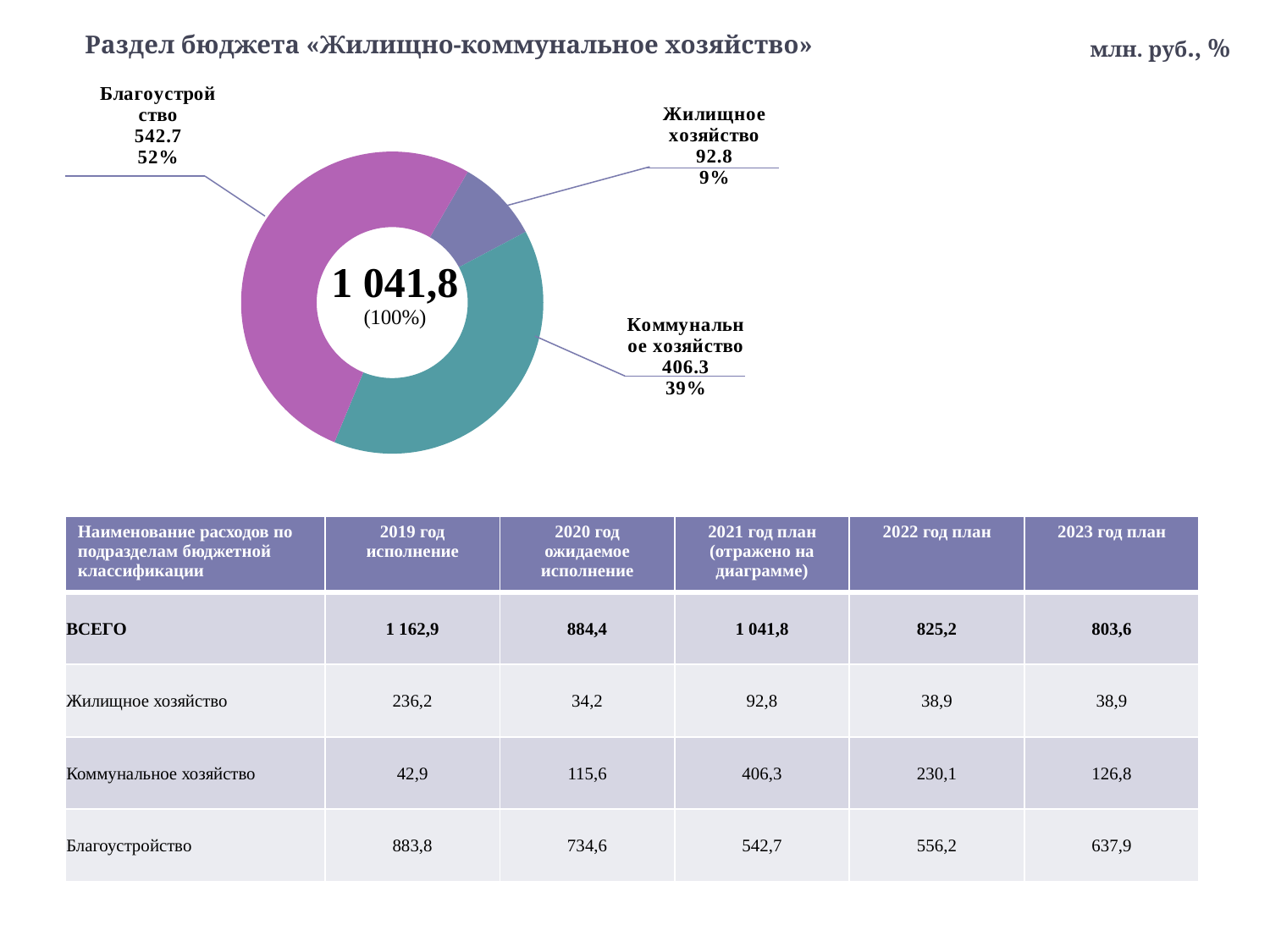
What value is shown for Благоустройство on the donut chart? 542.7 How many slices does the donut chart have? 3 What value is shown for Жилищное хозяйство on the donut chart? 92.8 What share of the donut chart does Коммунальное хозяйство represent? 39% What total value is shown in the centre of the donut chart? 1 041,8 Which is larger on the donut chart: Коммунальное хозяйство or Жилищное хозяйство? Коммунальное хозяйство What share of the donut chart does Благоустройство represent? 52% What is the difference between the values for Благоустройство and Коммунальное хозяйство on the donut chart? 136.4 What value is shown for Коммунальное хозяйство on the donut chart? 406.3 Which category has the largest slice in the donut chart? Благоустройство Which category has the smallest slice in the donut chart? Жилищное хозяйство What kind of chart is shown on the slide? Pie (donut) chart